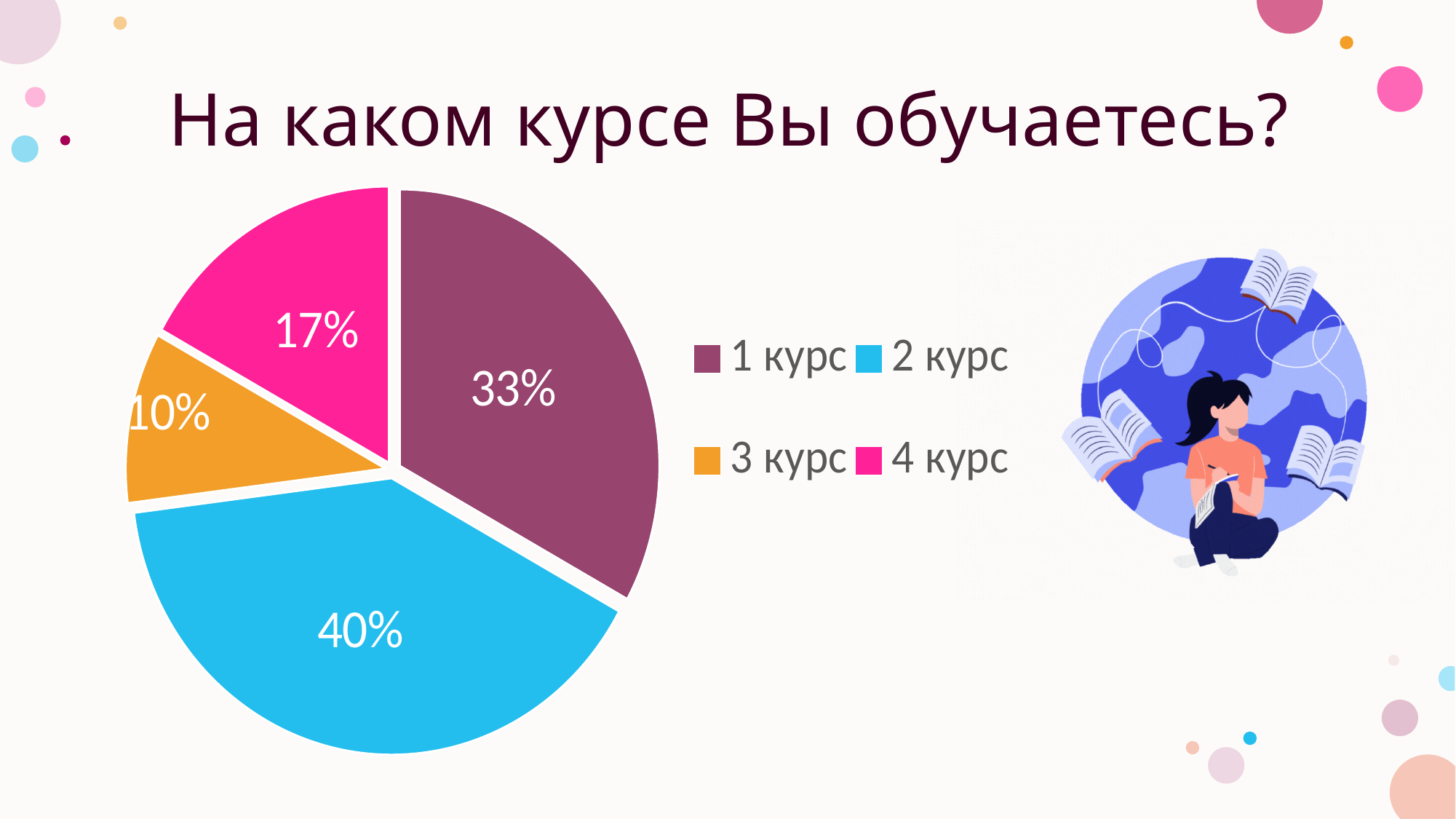
Which category has the largest slice of the pie? 2 курс Which is larger, the share of 1 курс or the share of 4 курс? 1 курс What kind of chart is shown on the slide? pie chart What is the difference between the shares of 2 курс and 1 курс? 7% How many categories does the pie chart show? 4 What share of the pie does 1 курс have? 33% What share of the pie does 2 курс have? 40% What share of the pie does 4 курс have? 17% Which category has the smallest slice of the pie? 3 курс What colour is the slice for 3 курс? orange What share of the pie does 3 курс have? 10% What is the difference between the shares of 4 курс and 3 курс? 7%